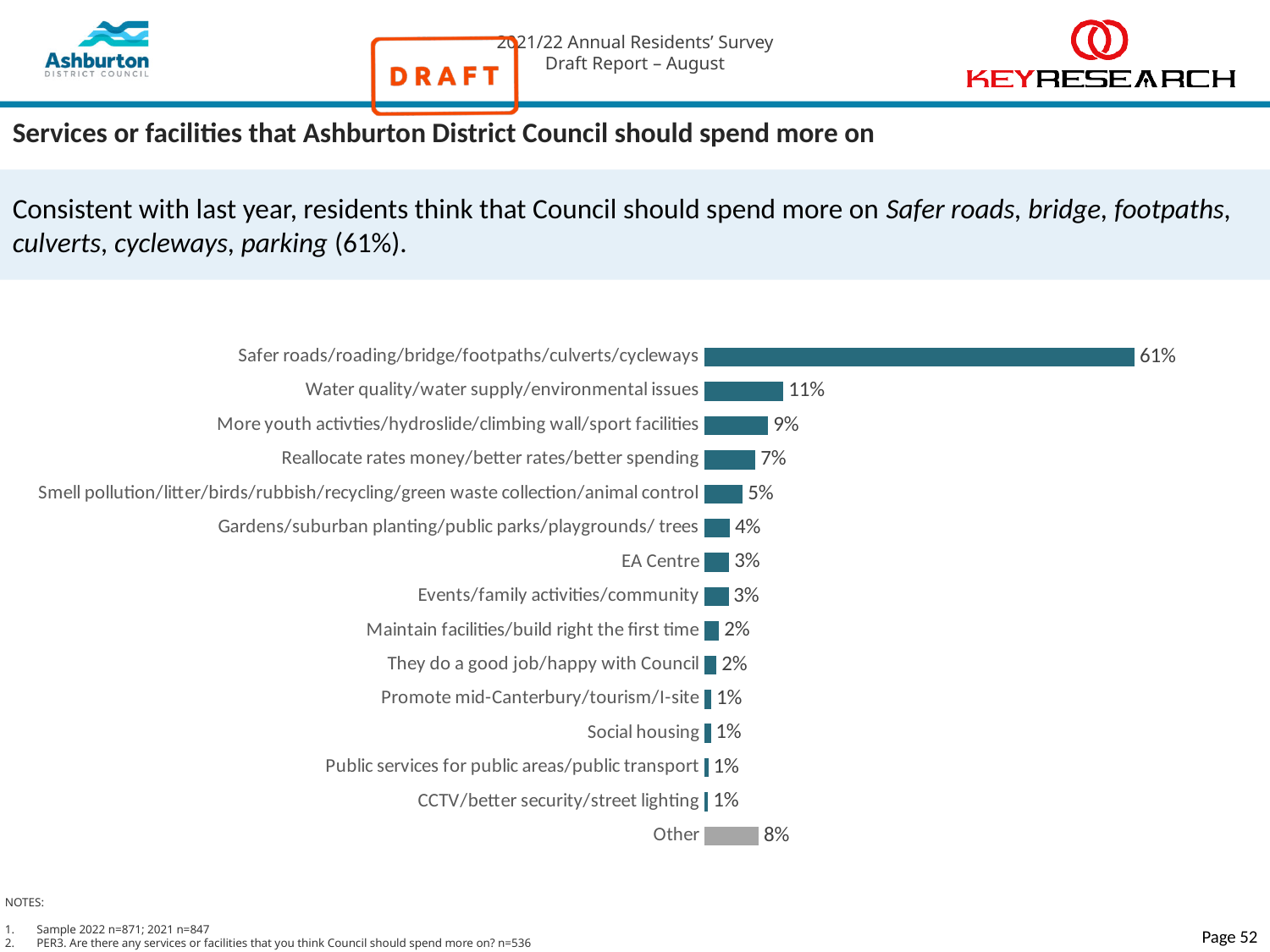
Which category has the highest value in the chart? Safer roads/roading/bridge/footpaths/culverts/cycleways Which bar in the chart is coloured grey rather than teal? Other Which is larger: the value for Water quality/water supply/environmental issues or the value for Other? Water quality/water supply/environmental issues What is the value for Reallocate rates money/better rates/better spending? 7% What percentage of residents said Council should spend more on Safer roads/roading/bridge/footpaths/culverts/cycleways? 61% What is the value for EA Centre? 3% What is the value for Other? 8% What kind of chart is shown on the slide? bar chart Which is larger: the value for More youth activties/hydroslide/climbing wall/sport facilities or the value for Smell pollution/litter/birds/rubbish/recycling/green waste collection/animal control? More youth activties/hydroslide/climbing wall/sport facilities What is the difference in percentage points between Safer roads/roading/bridge/footpaths/culverts/cycleways and Water quality/water supply/environmental issues? 50 percentage points How many categories are plotted in the chart? 15 What is the value for Water quality/water supply/environmental issues? 11%